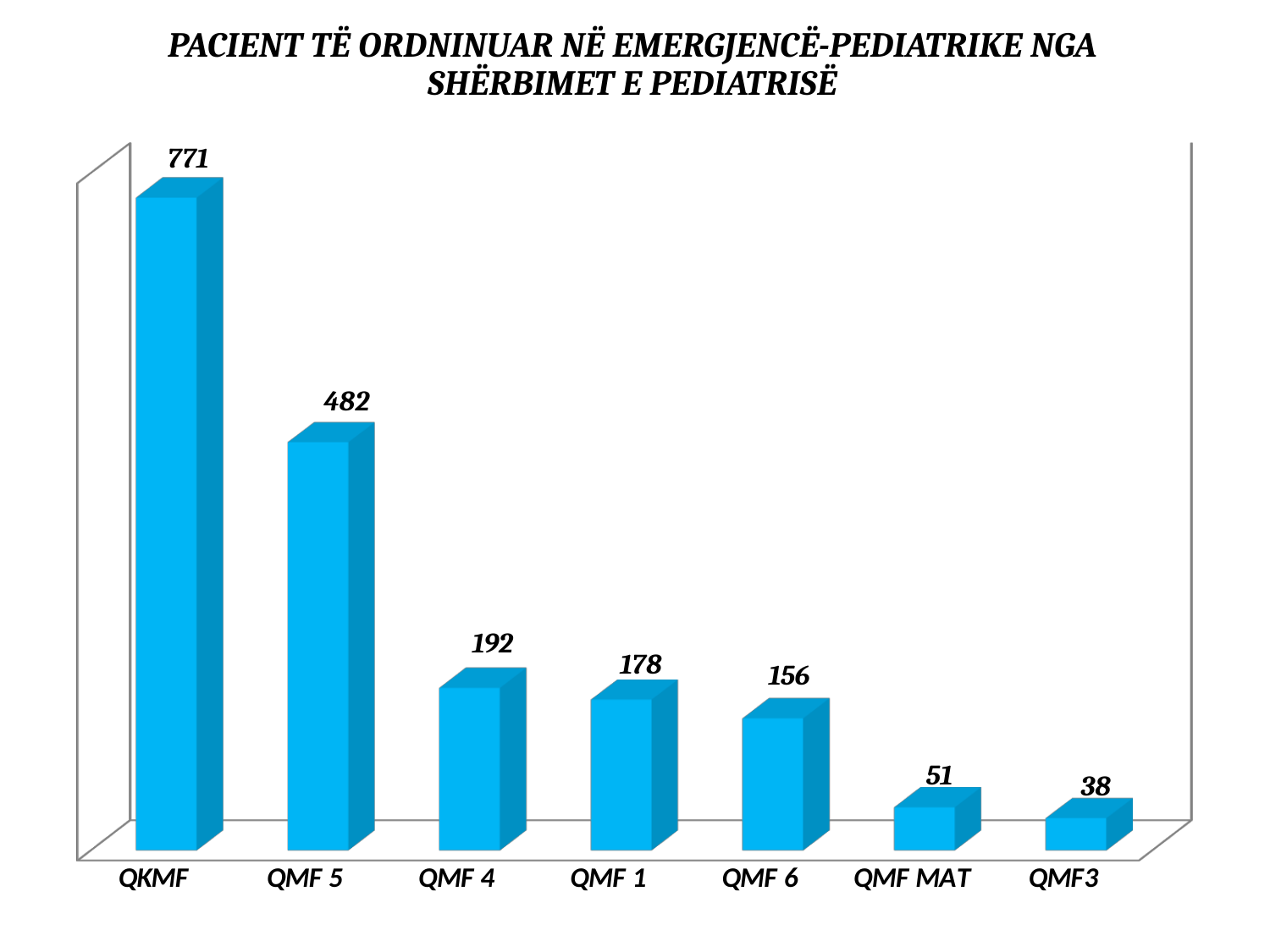
Which category has the lowest value? QMF3 Do the values rise or fall from left to right along the x axis? Fall Which is larger, the value for QMF 1 or the value for QMF 6? QMF 1 How many categories are shown on the chart? 7 What kind of chart is shown on the slide? Bar chart What is the difference between the values for QKMF and QMF 5? 289 What is the value for QMF MAT? 51 What is the value for QMF 5? 482 What is the value for QKMF? 771 What is the value for QMF 6? 156 Which category has the highest value? QKMF What is the difference between the values for QMF 4 and QMF 1? 14